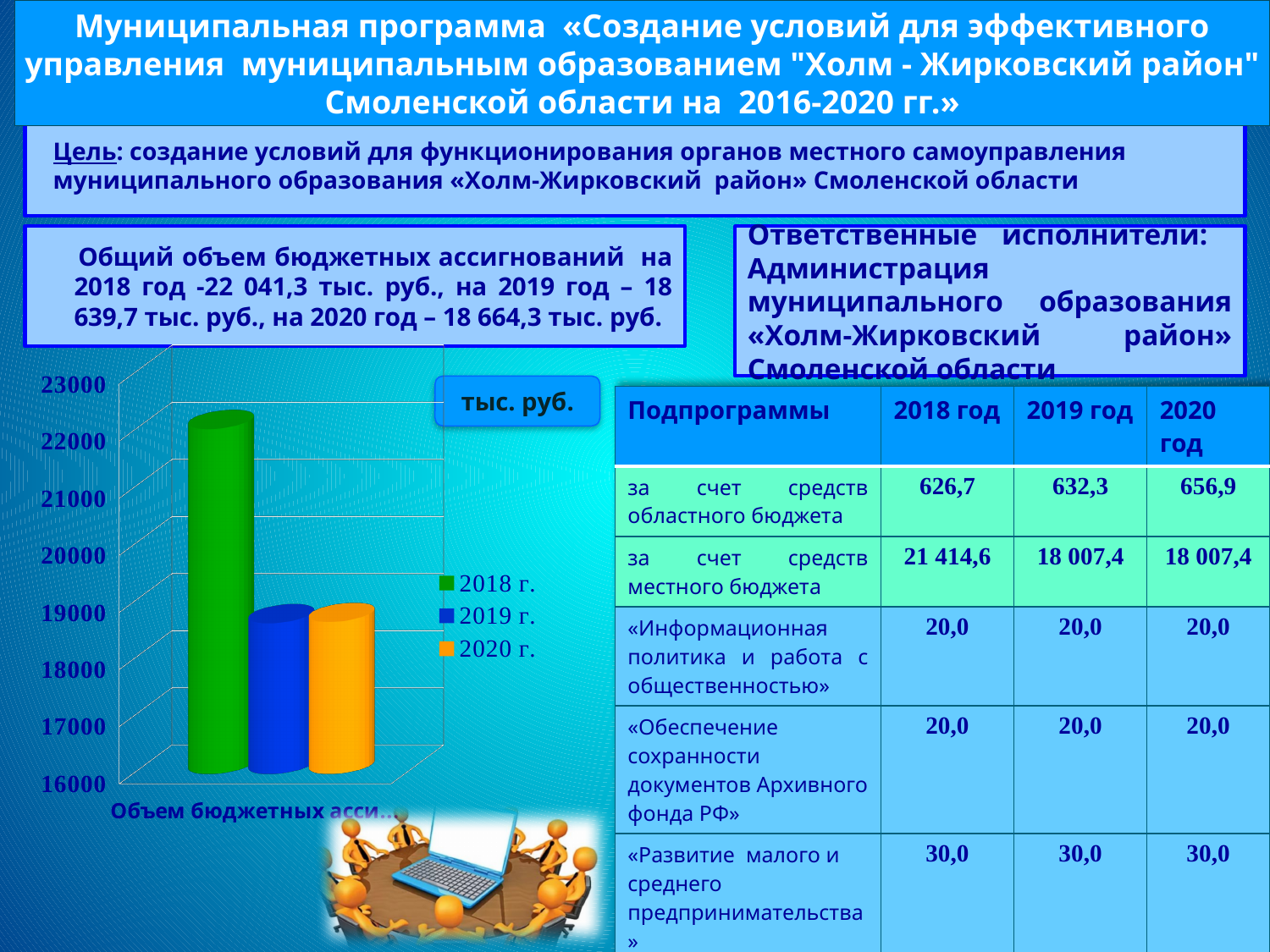
Is the bar for 2018 г. greater or less than 23000? less Which year has the highest bar in the chart? 2018 г. Is the bar for 2018 г. greater or less than 21000? greater How many series does the chart legend list? 3 Is the bar for 2020 г. greater or less than 18000? greater Which bar is taller, 2018 г. or 2019 г.? 2018 г. What colour is the bar for 2019 г. in the chart? blue What unit label is shown in the box above the chart legend? тыс. руб. How many bars are plotted in the chart? 3 What kind of chart is shown on the slide? bar chart Which bar is taller, 2020 г. or 2018 г.? 2018 г.